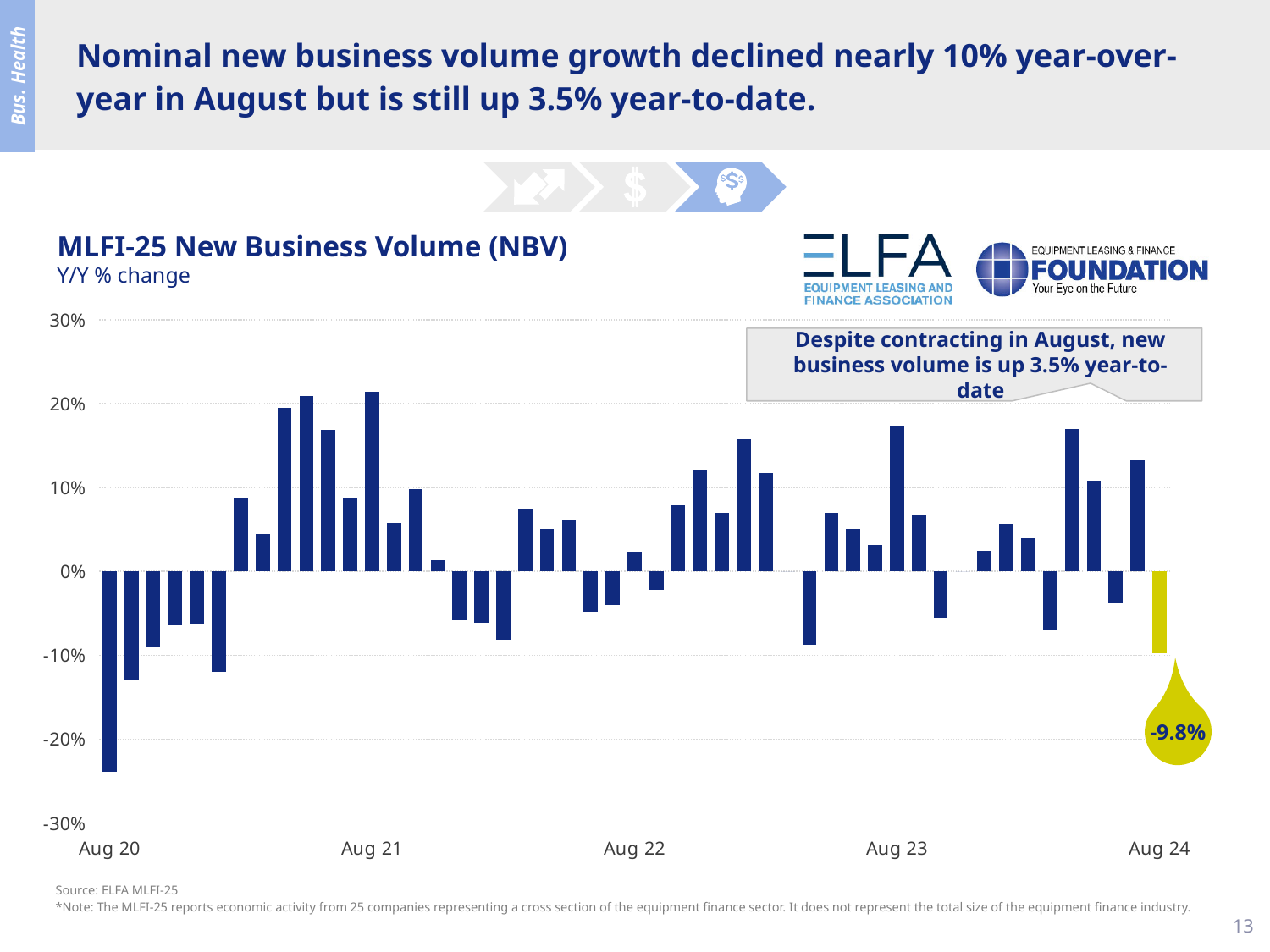
Is the value for Aug 20 greater or less than -20%? less What is the highest value shown on the y axis? 30% How many month labels are shown on the x axis? 5 Is the value for Aug 23 greater or less than 10%? greater What is the title of the chart? MLFI-25 New Business Volume (NBV) What kind of chart is used to show MLFI-25 New Business Volume? Bar chart Which is larger, the value for Aug 20 or the value for Aug 24? Aug 24 Which month shown on the x axis has the lowest Y/Y % change? Aug 20 What is the Y/Y % change in new business volume for Aug 24? -9.8% What unit or measure does the chart subtitle say the values are in? Y/Y % change Is the value for Aug 24 greater or less than 0%? less